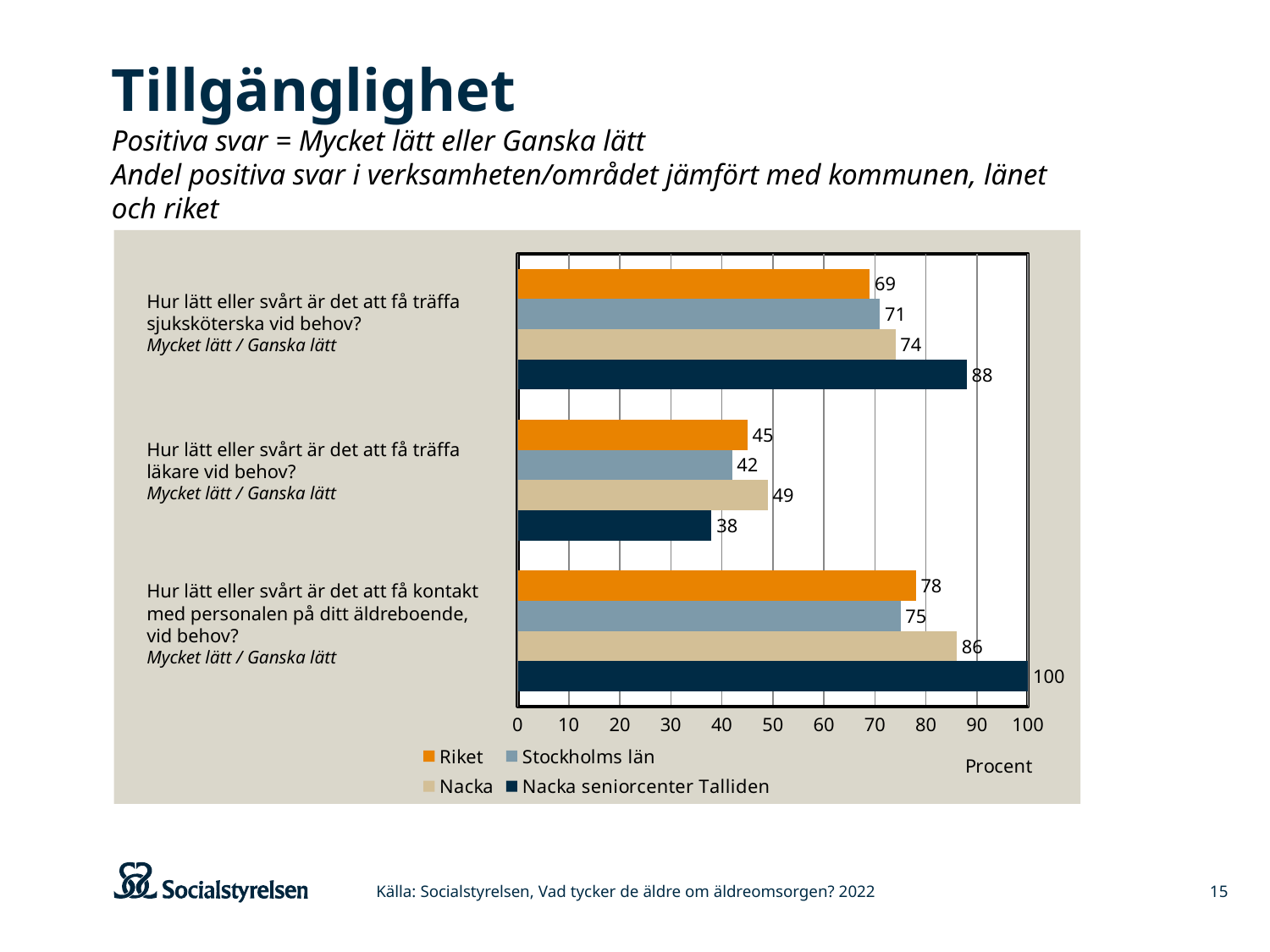
What is the difference between Nacka seniorcenter Talliden and Riket on the question about meeting a nurse (sjuksköterska)? 19 What is the unit label shown below the x axis of the chart? Procent How many question categories are shown on the chart? 3 How many series does the legend list? 4 What is the value for Nacka seniorcenter Talliden on the question about meeting a nurse (sjuksköterska) when needed? 88 Which is larger on the question about meeting a doctor (läkare): Nacka or Riket? Nacka Which series has the highest value on the question about contact with staff at the care home? Nacka seniorcenter Talliden What is the value for Nacka on the question about getting in contact with staff at the care home (kontakt med personalen)? 86 What is the value for Riket on the question about meeting a doctor (läkare) when needed? 45 Which series has the lowest value on the question about meeting a doctor (läkare) when needed? Nacka seniorcenter Talliden What is the value for Stockholms län on the question about meeting a doctor (läkare) when needed? 42 What type of chart is shown on the slide? Bar chart